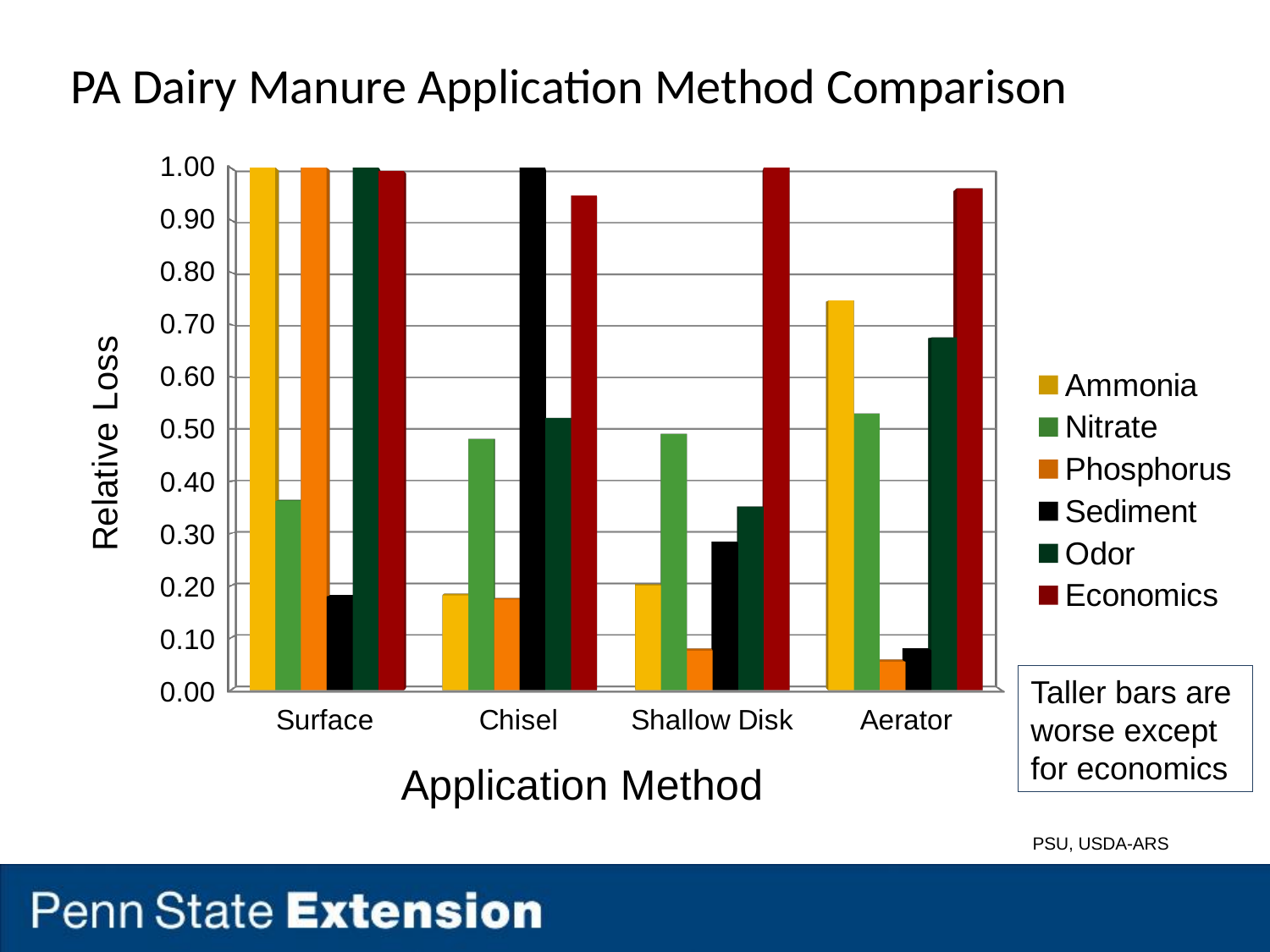
How many series does the legend list? 6 Which application method has the highest Sediment value? Chisel What is the relative loss for Ammonia under the Surface method? 1.00 Is the Ammonia value for Aerator greater or less than 0.70? greater What is the title of the y axis? Relative Loss What is the relative loss for Sediment under the Chisel method? 1.00 Which is larger, the Nitrate value for Surface or the Nitrate value for Aerator? Aerator Is the Phosphorus value for Chisel greater or less than 0.20? less How many application methods are shown on the x axis? 4 Is the Sediment value for Shallow Disk greater or less than 0.30? less What kind of chart is shown on the slide? bar chart Which application method has the lowest Odor value? Shallow Disk